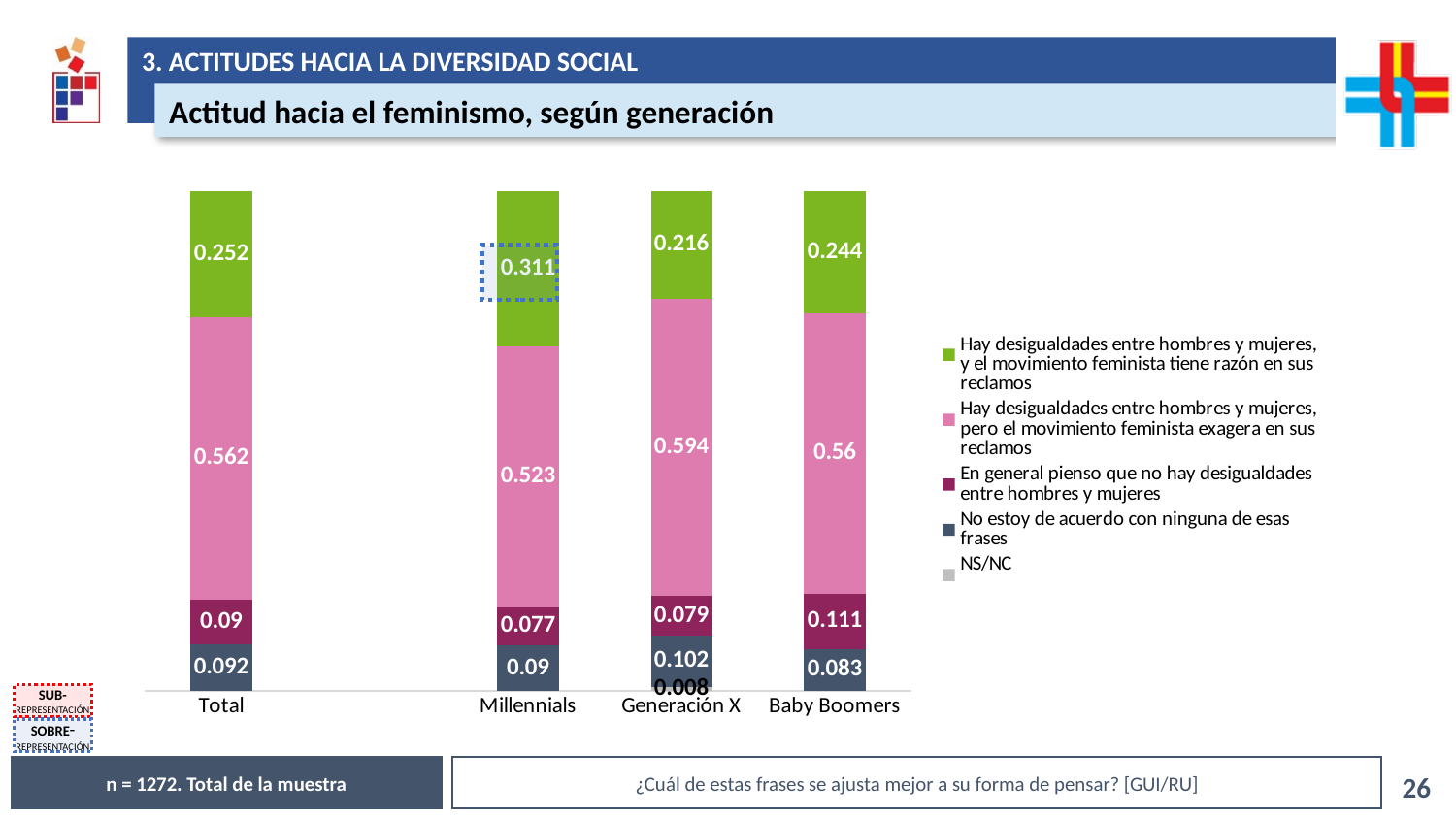
What is the difference between the Millennials and Total values in the series 'Hay desigualdades entre hombres y mujeres, y el movimiento feminista tiene razón en sus reclamos'? 0.059 What is the value for Millennials in the series 'Hay desigualdades entre hombres y mujeres, y el movimiento feminista tiene razón en sus reclamos'? 0.311 What is the value for Total in the series 'No estoy de acuerdo con ninguna de esas frases'? 0.092 How many series does the legend list? 5 How many categories are shown on the x axis of the chart? 4 What is the value for Baby Boomers in the series 'En general pienso que no hay desigualdades entre hombres y mujeres'? 0.111 What is the NS/NC value shown for Generación X? 0.008 What is the value for Generación X in the series 'Hay desigualdades entre hombres y mujeres, pero el movimiento feminista exagera en sus reclamos'? 0.594 Which generation has the highest value in the series 'Hay desiguales entre hombres y mujeres, y el movimiento feminista tiene razón en sus reclamos'? Millennials Which category has the lowest value in the series 'En general pienso que no hay desigualdades entre hombres y mujeres'? Millennials What kind of chart is shown on the slide? Stacked bar chart Which is larger in the series 'Hay desigualdades entre hombres y mujeres, pero el movimiento feminista exagera en sus reclamos': Generación X or Millennials? Generación X